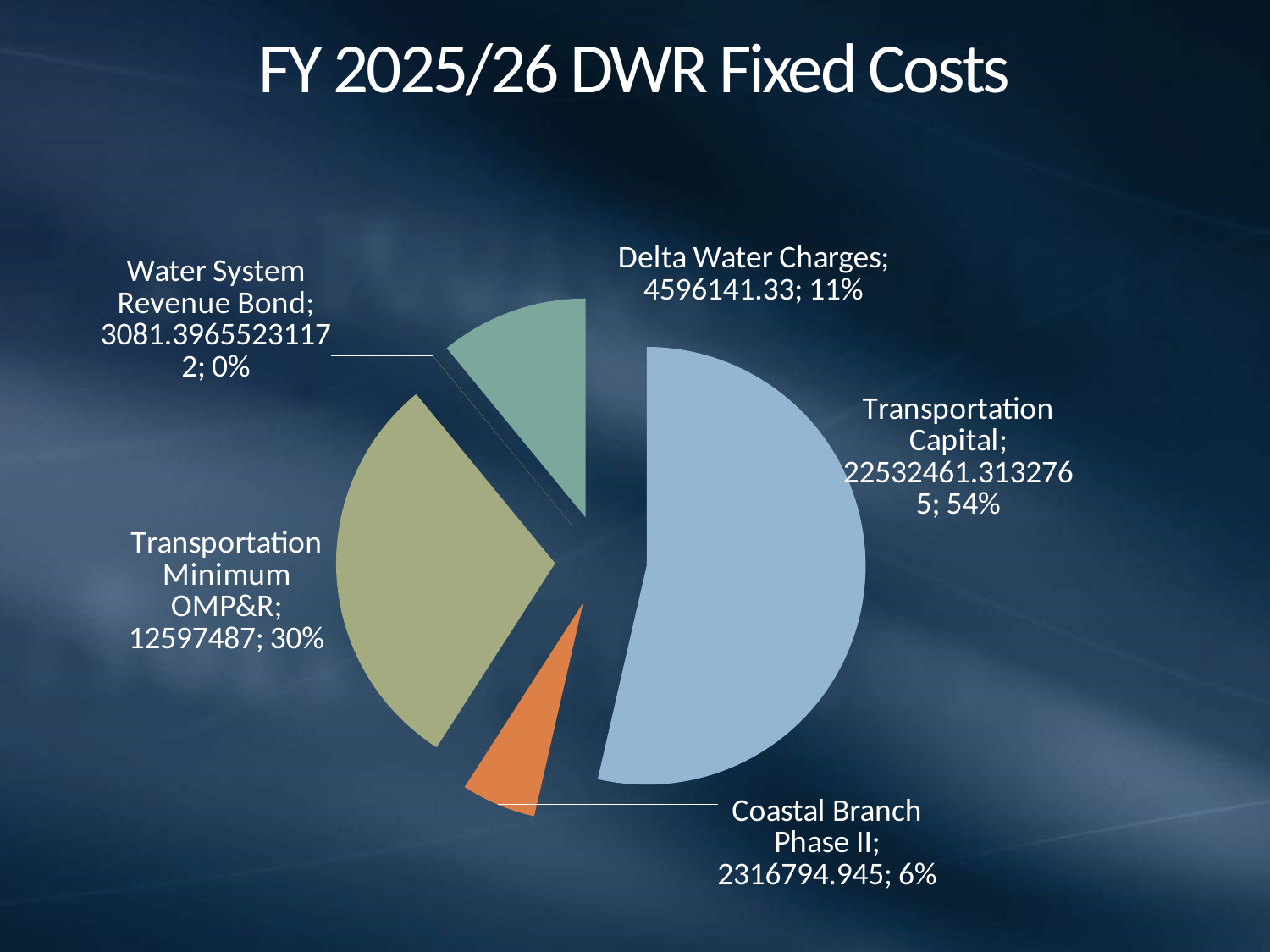
What type of chart is shown on the slide? pie chart What is the value for Coastal Branch Phase II? 2316794.945 What is the title of the chart? FY 2025/26 DWR Fixed Costs Which is larger, Delta Water Charges or Coastal Branch Phase II? Delta Water Charges Which category has the largest share of the pie? Transportation Capital What is the value for Delta Water Charges? 4596141.33 How many slices does the pie chart have? 5 What is the difference between the values for Transportation Minimum OMP&R and Delta Water Charges? 8001345.67 Which category has the smallest share of the pie? Water System Revenue Bond What percentage share does Transportation Capital have? 54% What is the value for Transportation Minimum OMP&R? 12597487 What percentage share does Transportation Minimum OMP&R have? 30%